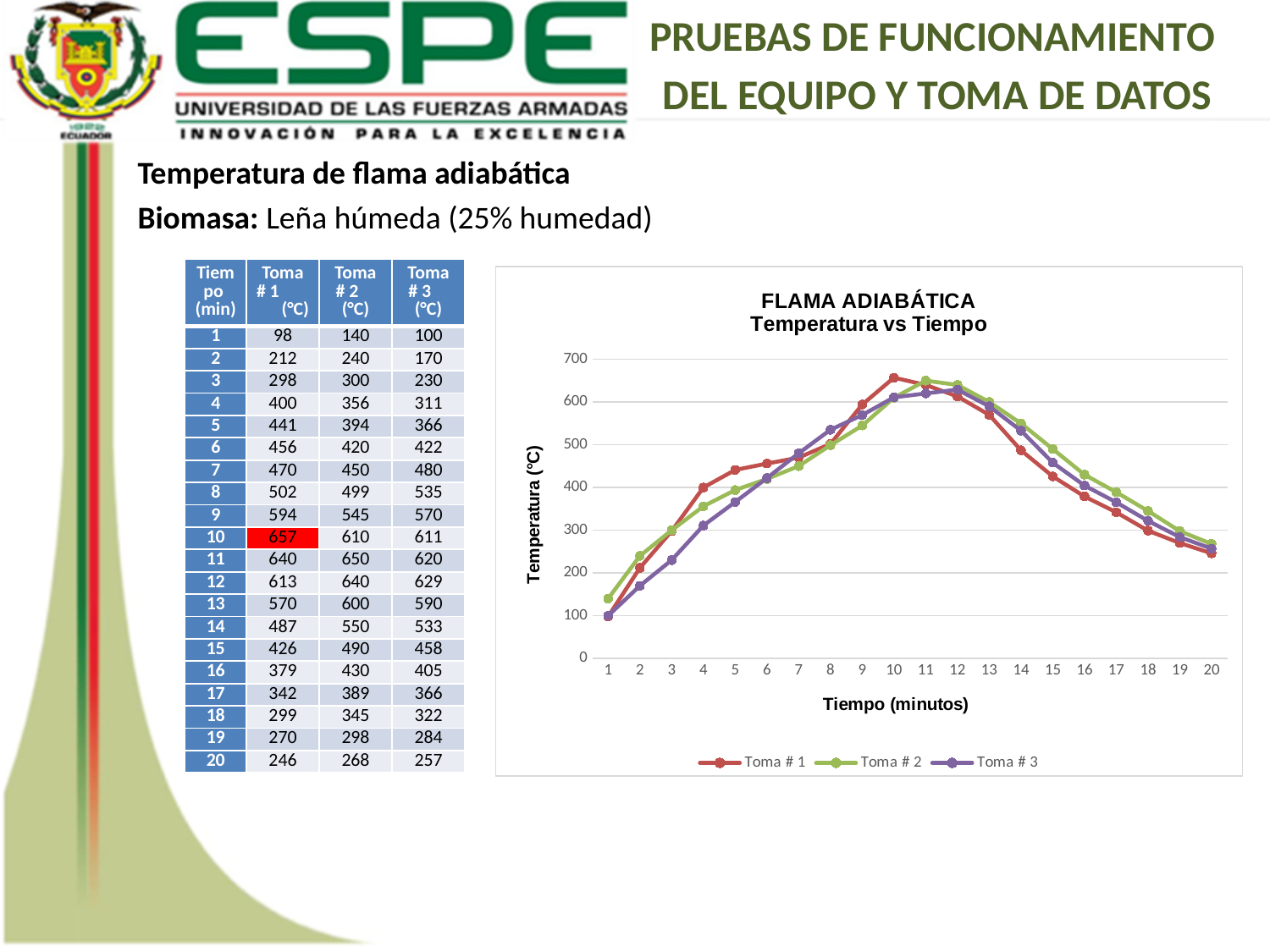
How many series does the legend of the FLAMA ADIABÁTICA chart list? 3 What is the temperature of Toma # 2 at minute 11? 650 At which minute does Toma # 1 reach its highest temperature? 10 What is the title of the y axis of the chart? Temperatura (°C) What kind of chart is shown on the slide? line chart At minute 1, which is larger: Toma # 1 or Toma # 2? Toma # 2 Is the value for Toma # 1 at minute 10 greater or less than 600? greater How many time points are plotted along the x axis of the chart? 20 Do the temperatures rise or fall from minute 12 to minute 20? fall What is the difference between Toma # 1 and Toma # 2 at minute 10? 47 What is the temperature of Toma # 1 at minute 10? 657 What is the temperature of Toma # 3 at minute 20? 257